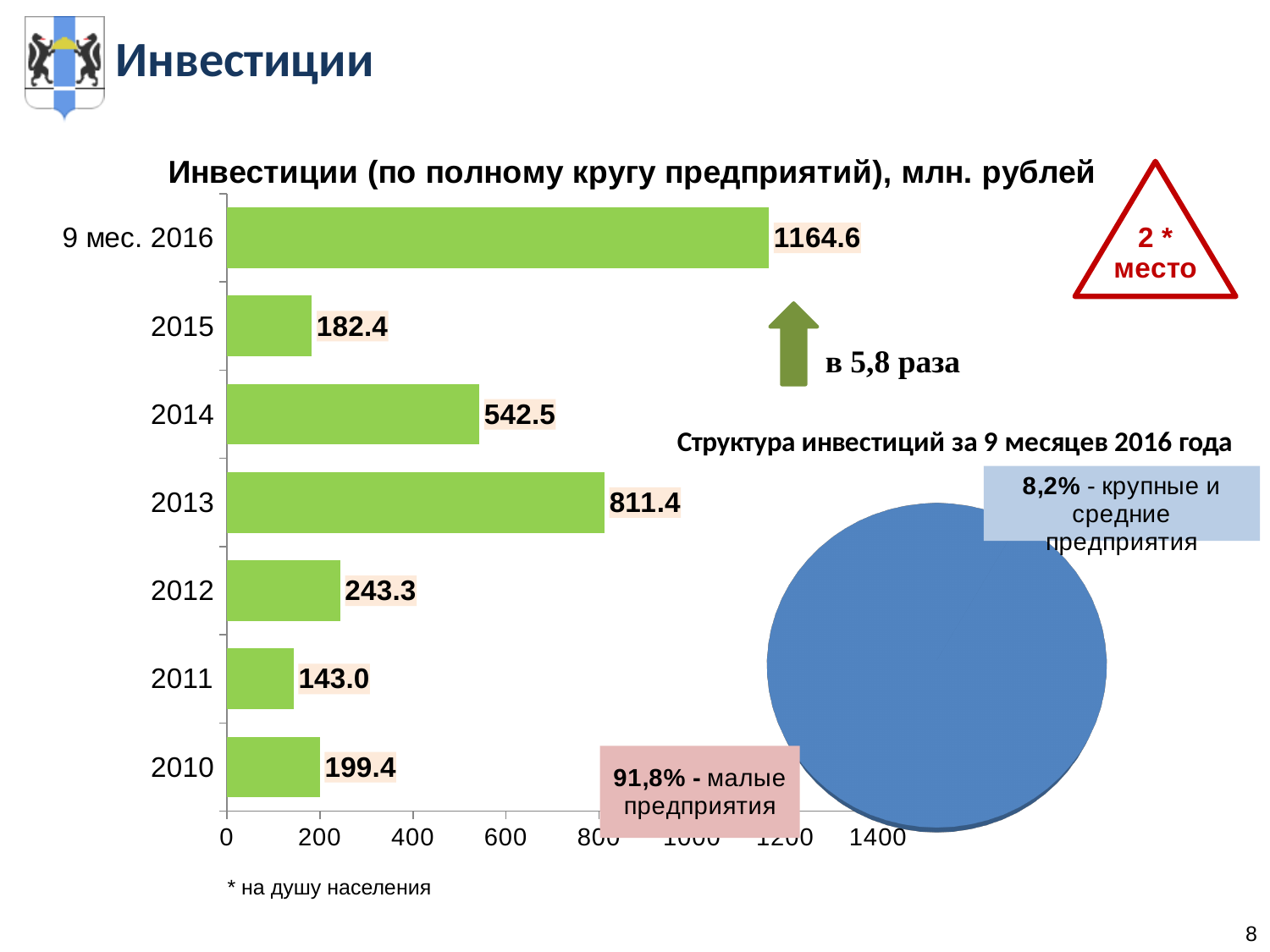
On the bar chart 'Инвестиции (по полному кругу предприятий), млн. рублей', which category has the highest value? 9 мес. 2016 On the bar chart 'Инвестиции (по полному кругу предприятий), млн. рублей', what is the value for 9 мес. 2016? 1164.6 On the bar chart 'Инвестиции (по полному кругу предприятий), млн. рублей', what is the value for 2011? 143.0 On the bar chart 'Инвестиции (по полному кругу предприятий), млн. рублей', is the value for 2013 greater or less than 800? greater On the bar chart 'Инвестиции (по полному кругу предприятий), млн. рублей', what is the value for 2013? 811.4 On the bar chart 'Инвестиции (по полному кругу предприятий), млн. рублей', which is larger: the value for 2012 or the value for 2010? 2012 What kind of chart is 'Инвестиции (по полному кругу предприятий), млн. рублей'? bar chart On the pie chart 'Структура инвестиций за 9 месяцев 2016 года', what share do малые предприятия have? 91,8% On the bar chart 'Инвестиции (по полному кругу предприятий), млн. рублей', which category has the lowest value? 2011 How many categories are shown on the bar chart 'Инвестиции (по полному кругу предприятий), млн. рублей'? 7 On the bar chart 'Инвестиции (по полному кругу предприятий), млн. рублей', what is the difference between the values for 2014 and 2015? 360.1 On the pie chart 'Структура инвестиций за 9 месяцев 2016 года', what share do крупные и средние предприятия have? 8,2%